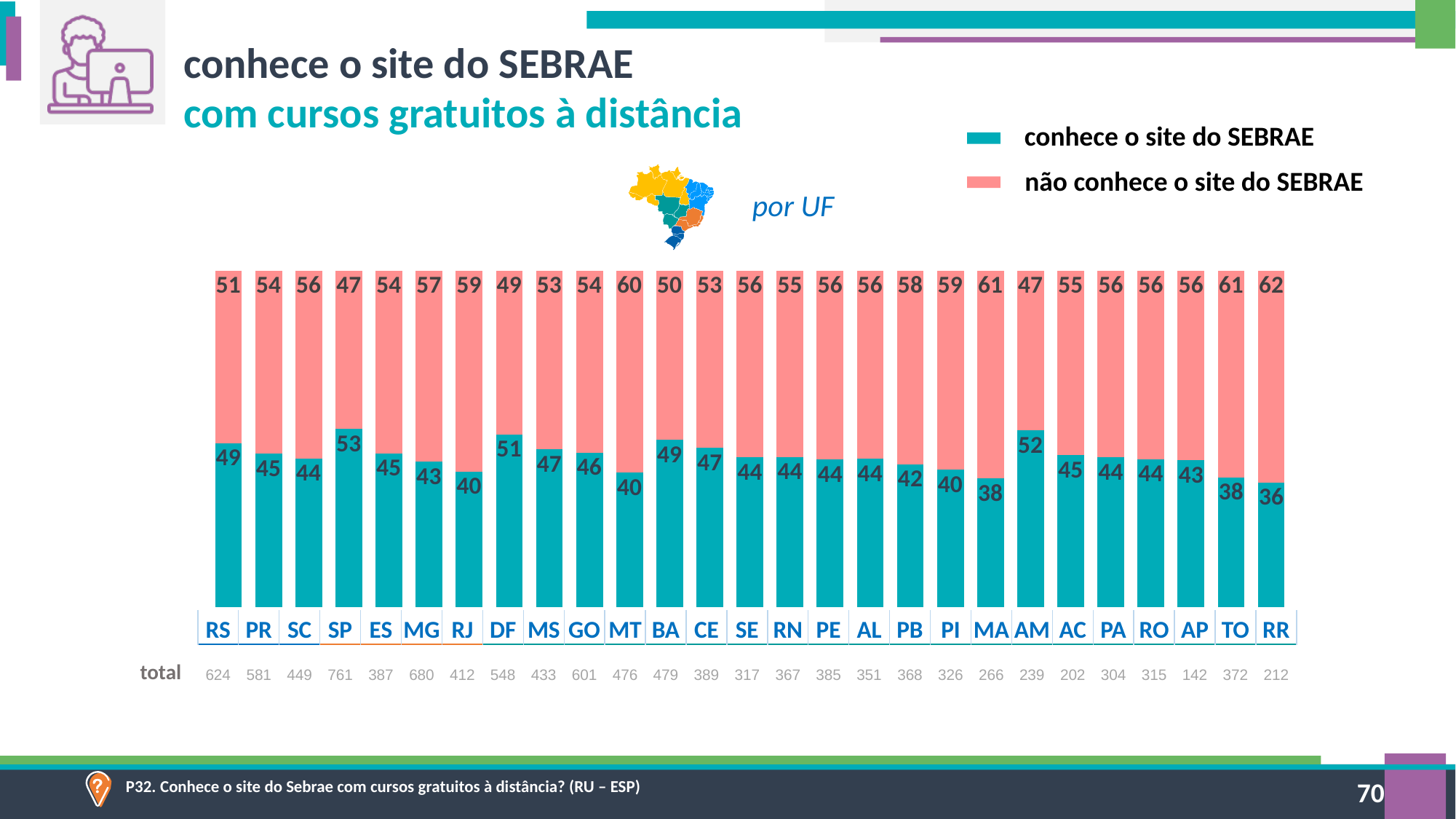
What is the value for "não conhece o site do SEBRAE" for MT? 60 What is the value for "conhece o site do SEBRAE" for AM? 52 Which UF has the highest value for "não conhece o site do SEBRAE"? RR How many UFs (categories) are shown on the x axis? 27 Which UF has the lowest value for "conhece o site do SEBRAE"? RR Which UF has the highest value for "conhece o site do SEBRAE"? SP What is the value for "conhece o site do SEBRAE" for SP? 53 What kind of chart is shown on the slide? Stacked bar chart How many series does the legend list? 2 What is the difference between the "não conhece" and "conhece" values for RR? 26 What is the total (base) shown below the chart for SP? 761 Which is larger: the "conhece o site do SEBRAE" value for DF or for RJ? DF